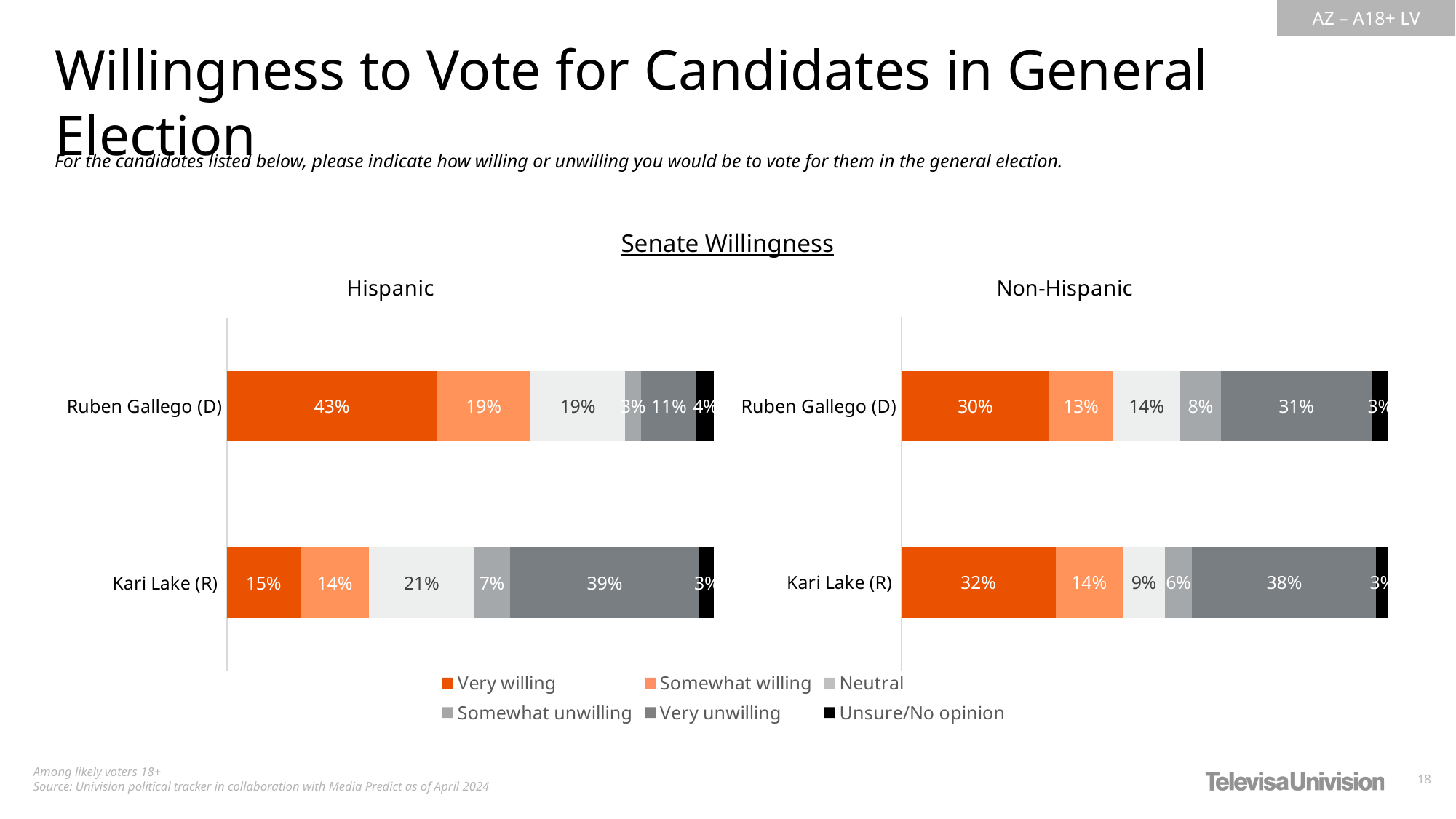
In the Hispanic chart, what is the difference between the very willing percentages for Ruben Gallego (D) and Kari Lake (R)? 28 percentage points In the Hispanic chart, which candidate has the higher somewhat unwilling percentage? Kari Lake (R) How many candidates are shown in the Hispanic chart? 2 In the Hispanic chart, what percentage of respondents are very willing to vote for Ruben Gallego (D)? 43% In the Non-Hispanic chart, which candidate has the higher very unwilling percentage, Ruben Gallego (D) or Kari Lake (R)? Kari Lake (R) In the Non-Hispanic chart, what percentage of respondents are neutral about voting for Ruben Gallego (D)? 14% In the Non-Hispanic chart, what percentage of respondents are very willing to vote for Kari Lake (R)? 32% In the Non-Hispanic chart, what is the combined very willing and somewhat willing percentage for Ruben Gallego (D)? 43% Which legend entry is shown in black? Unsure/No opinion In the Hispanic chart, what percentage of respondents are very unwilling to vote for Kari Lake (R)? 39% How many series does the legend list? 6 What kind of chart is used for the Non-Hispanic data? Stacked bar chart